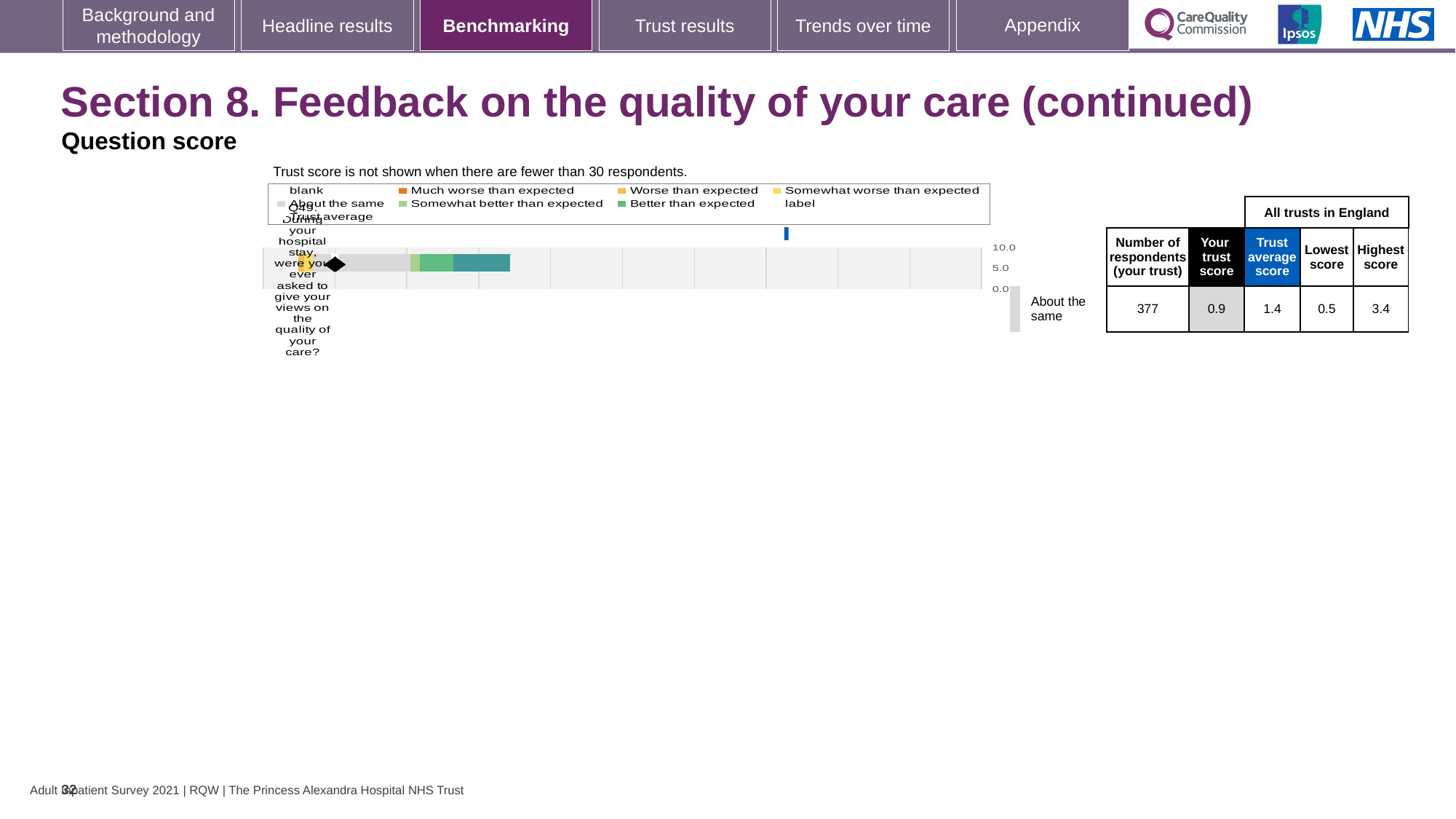
What is the 'Your trust score' value for Q49? 0.9 What kind of chart is used to show the Q49 question score? bar chart What is the 'Trust average score' for Q49? 1.4 What is the lowest score across all trusts in England for Q49? 0.5 What is the difference between the highest score and the lowest score for Q49? 2.9 Which is larger for Q49: your trust score or the trust average score? Trust average score Is your trust score for Q49 greater or less than 5.0 on the chart axis? less What is the difference between the trust average score and your trust score for Q49? 0.5 What is the highest score across all trusts in England for Q49? 3.4 What benchmark category is shown next to the Q49 bar? About the same How many respondents from your trust answered Q49? 377 How many questions are plotted on the chart? 1